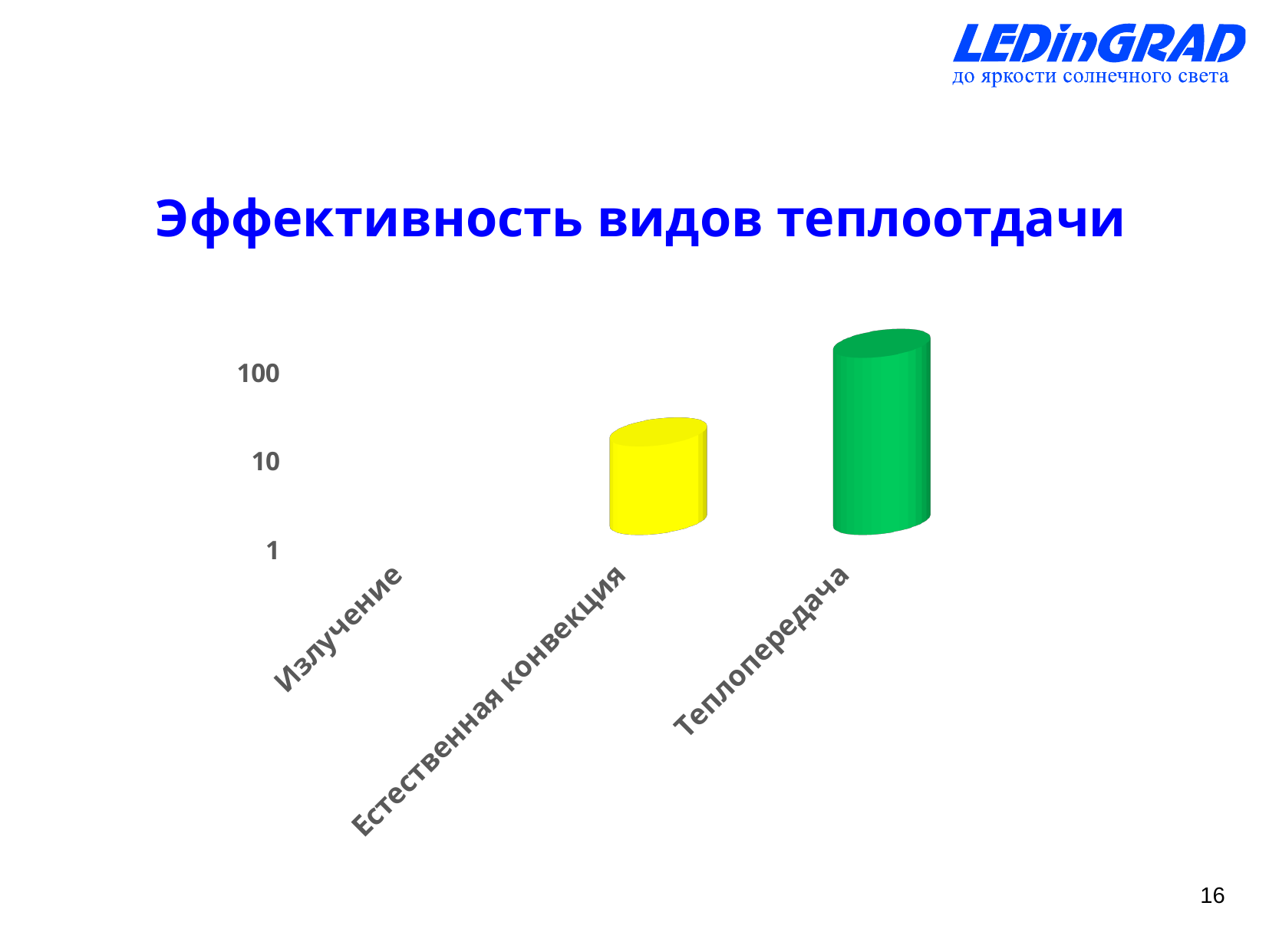
What kind of chart is shown on the slide? bar chart Is the value for Излучение greater or less than 10? less Is the value for Естественная конвекция greater or less than 100? less Which category has the highest value in the chart? Теплопередача Is the value for Теплопередача greater or less than 10? greater What colour is the bar for Теплопередача? green Which is larger, the value for Теплопередача or the value for Естественная конвекция? Теплопередача Which category has the lowest value in the chart? Излучение What is the title of the chart on the slide? Эффективность видов теплоотдачи How many categories are shown on the x axis of the chart? 3 Do the values rise or fall from left to right along the x axis? rise